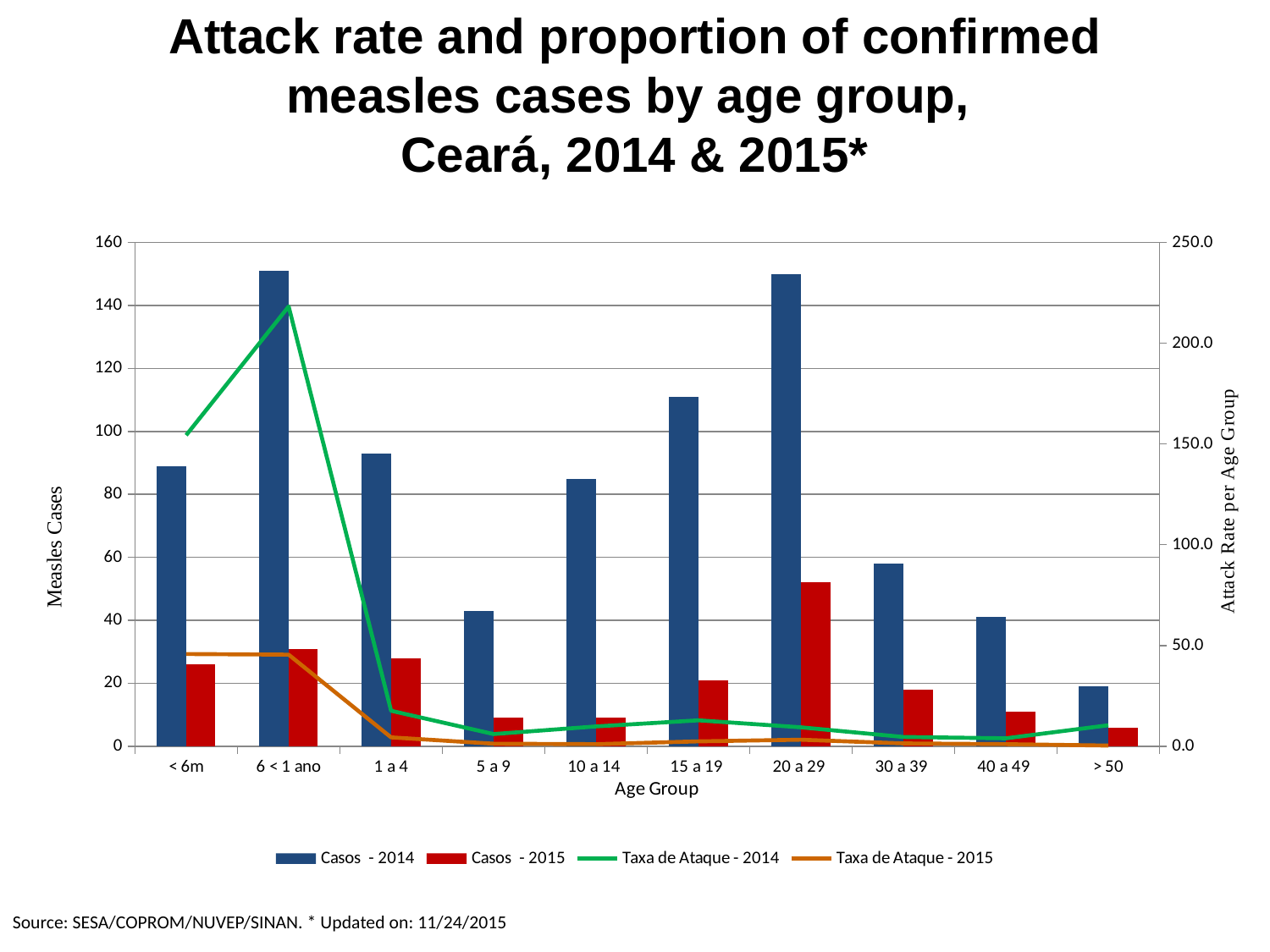
Is the Casos - 2014 value for the 15 a 19 age group greater or less than 100? greater Which age group has the highest Taxa de Ataque - 2014? 6 < 1 ano Does the Taxa de Ataque - 2014 line rise or fall from the 6 < 1 ano age group to the 5 a 9 age group? It falls What kind of chart is shown on the slide? A combination bar and line chart How many age groups are shown on the x axis? 10 Which age group has the highest value for Casos - 2015? 20 a 29 What is the title of the right-hand vertical axis? Attack Rate per Age Group Which age group has the lowest value for Casos - 2014? > 50 How many series does the legend list? 4 Is the Casos - 2014 value for the 5 a 9 age group greater or less than 60? less Is the Taxa de Ataque - 2014 value for the 6 < 1 ano age group greater or less than 200.0? greater Which has more Casos - 2014: the 10 a 14 age group or the 30 a 39 age group? 10 a 14